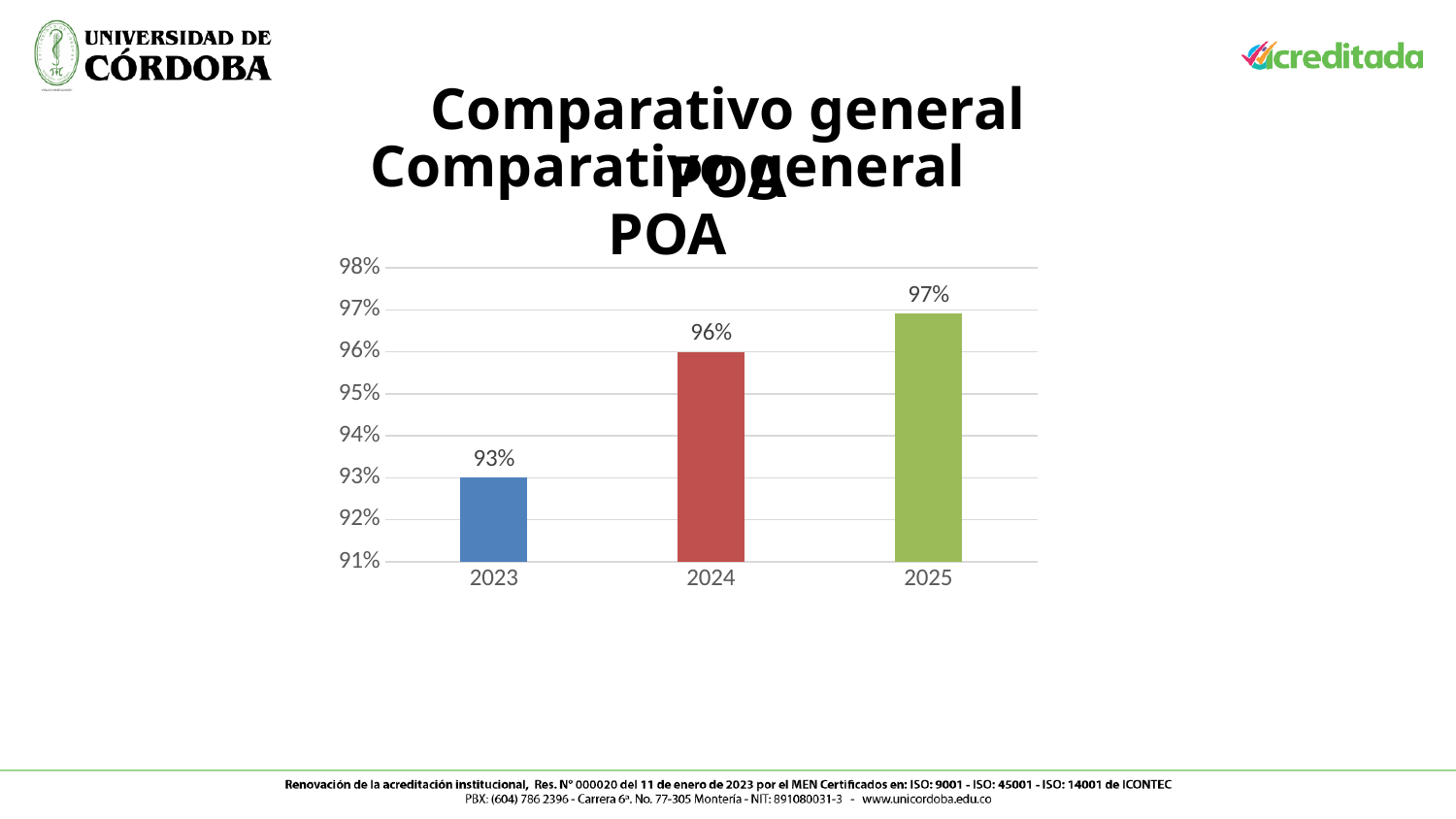
What is the value for 2024? 96% What kind of chart is shown on the slide? bar chart What is the value for 2025? 97% How many years are shown on the x axis? 3 Which year has the highest value? 2025 What is the value for 2023? 93% Is the value for 2023 greater or less than 95%? less Which year has the lowest value? 2023 Do the values rise or fall from 2023 to 2025? rise What is the difference between the values for 2025 and 2023? 4% Which is larger, the value for 2024 or the value for 2023? 2024 What is the difference between the values for 2024 and 2023? 3%